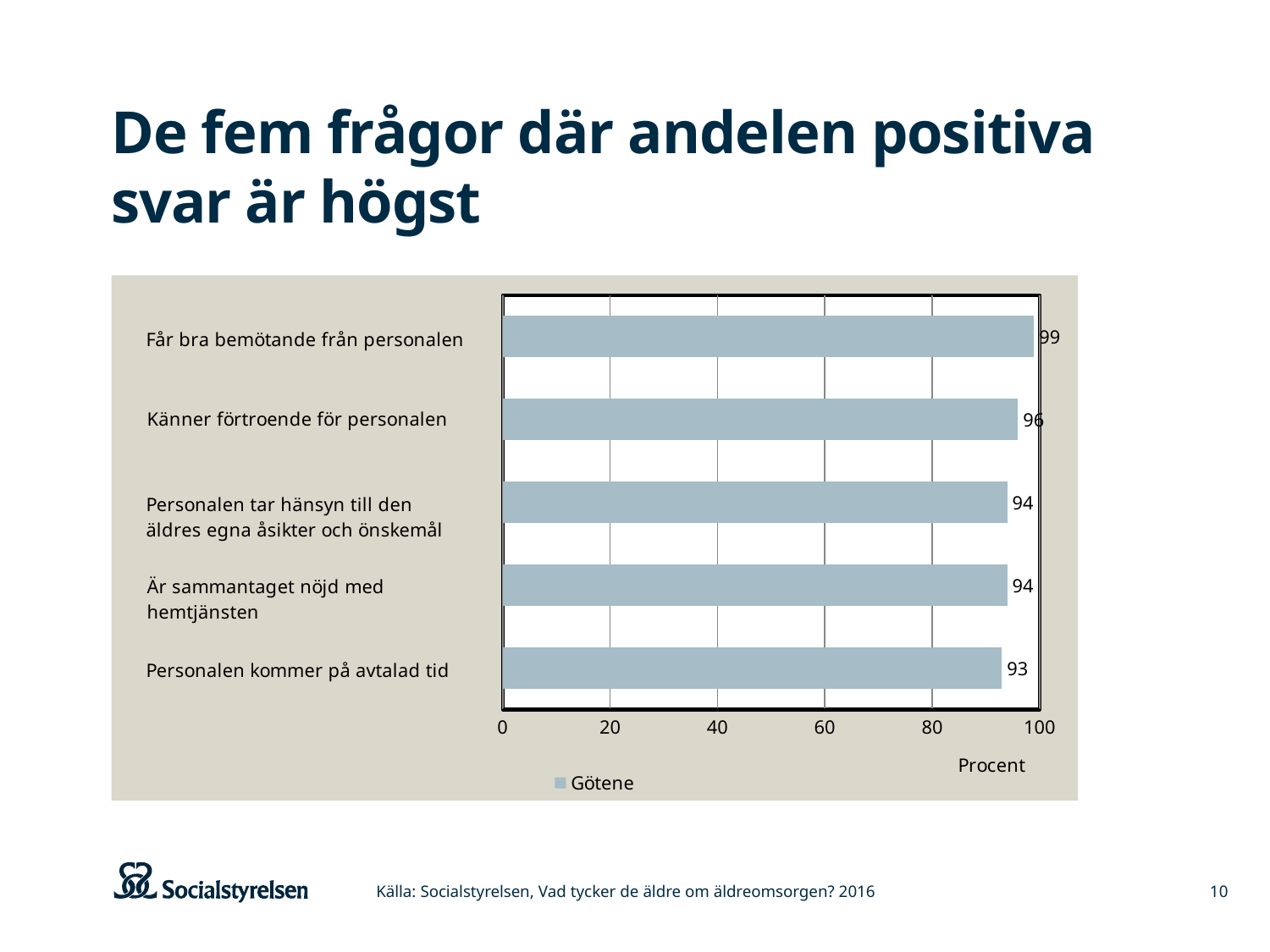
Which category has the highest value? Får bra bemötande från personalen What is the value for "Får bra bemötande från personalen"? 99 Is the value for "Personalen kommer på avtalad tid" greater or less than 80? greater What is the value for "Känner förtroende för personalen"? 96 What is the value for "Personalen kommer på avtalad tid"? 93 Which is larger, the value for "Känner förtroende för personalen" or the value for "Personalen tar hänsyn till den äldres egna åsikter och önskemål"? Känner förtroende för personalen What series does the legend list? Götene Which category has the lowest value? Personalen kommer på avtalad tid How many categories are shown in the chart? 5 What is the value for "Är sammantaget nöjd med hemtjänsten"? 94 What is the difference between the values for "Får bra bemötande från personalen" and "Personalen kommer på avtalad tid"? 6 What kind of chart is shown on the slide? bar chart